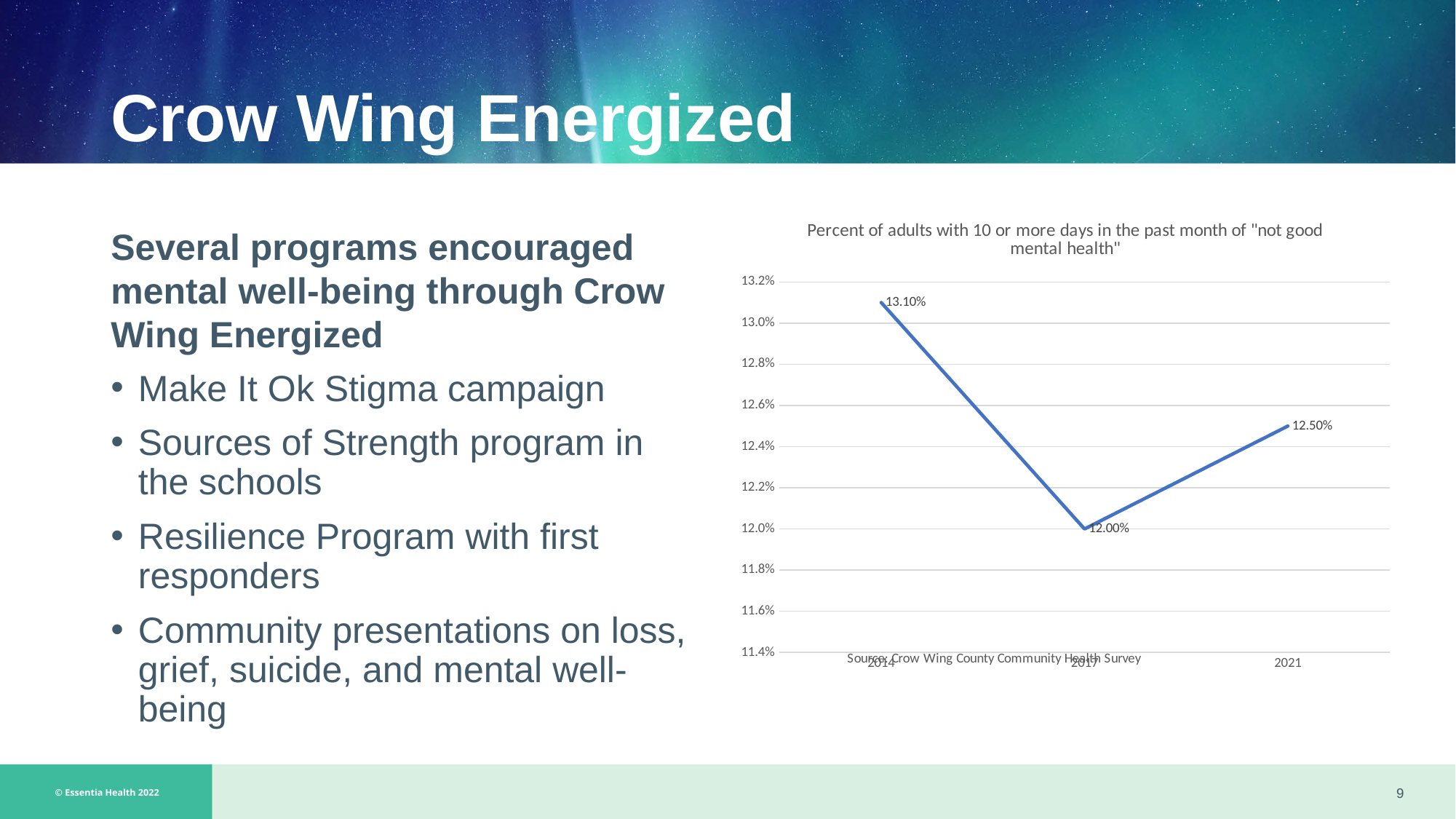
What is the title of the chart? Percent of adults with 10 or more days in the past month of "not good mental health" Which year has the highest value? 2014 What is the difference between the 2021 and 2017 values? 0.50% How many data points are plotted on the chart? 3 Is the value for 2021 greater or less than 12.0%? greater What is the value for 2014? 13.10% What is the difference between the 2014 and 2017 values? 1.10% Which year has the lowest value? 2017 What kind of chart is shown? line chart What is the value for 2021? 12.50% What is the value for 2017? 12.00% Which is larger, the value for 2014 or the value for 2021? 2014